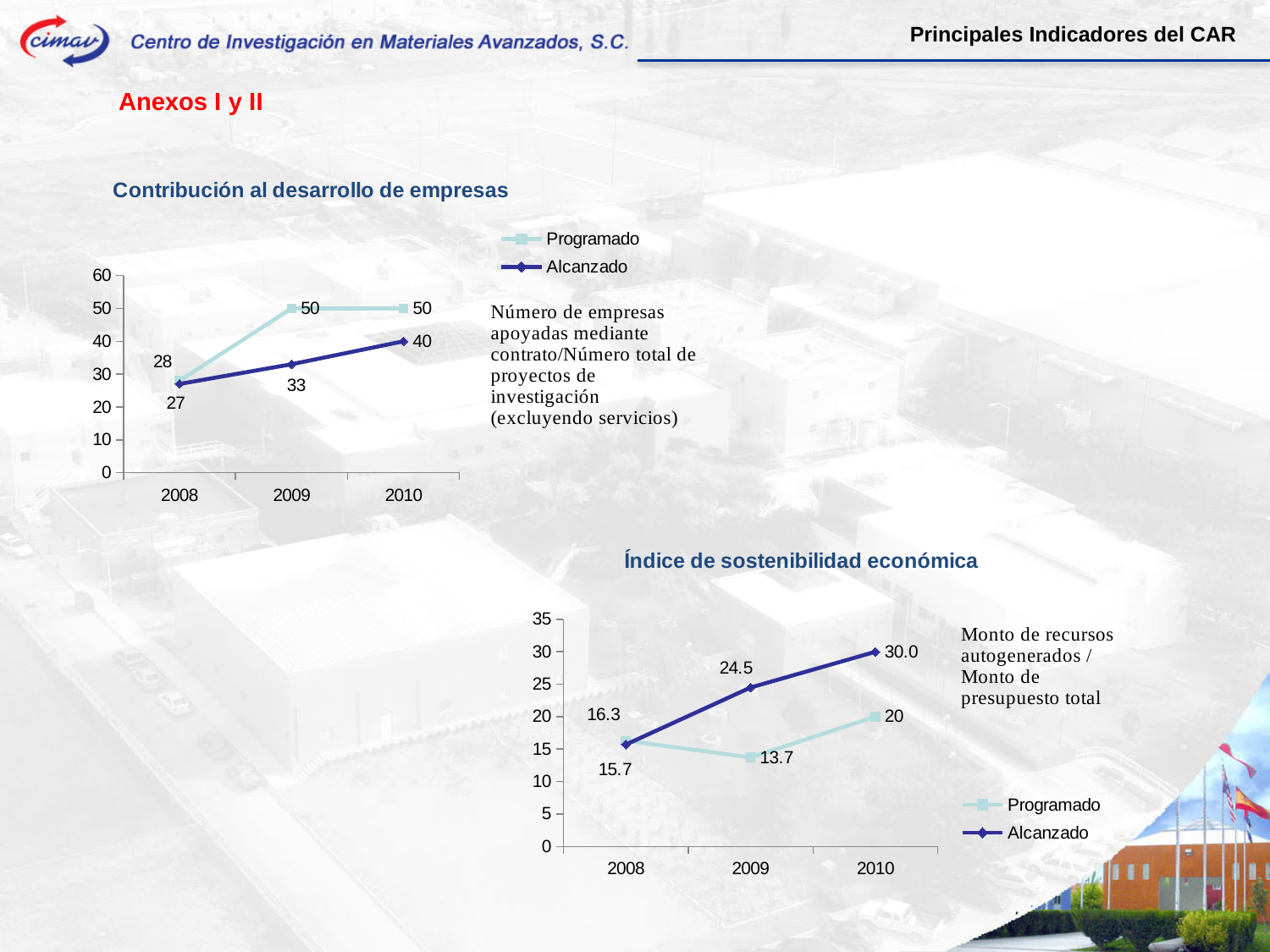
In the 'Contribución al desarrollo de empresas' chart, what is the difference between the Programado and Alcanzado values for 2010? 10 In the 'Índice de sostenibilidad económica' chart, which is larger in 2010, Programado or Alcanzado? Alcanzado In the 'Contribución al desarrollo de empresas' chart, what is the Alcanzado value for 2010? 40 In the 'Índice de sostenibilidad económica' chart, what is the Alcanzado value for 2009? 24.5 What kind of chart is 'Índice de sostenibilidad económica'? line chart In the 'Índice de sostenibilidad económica' chart, what is the Alcanzado value for 2010? 30.0 In the 'Contribución al desarrollo de empresas' chart, does the Alcanzado series rise or fall from 2008 to 2010? rise In the 'Índice de sostenibilidad económica' chart, which year has the highest Alcanzado value? 2010 In the 'Contribución al desarrollo de empresas' chart, what is the Programado value for 2009? 50 In the 'Contribución al desarrollo de empresas' chart, what is the Alcanzado value for 2009? 33 In the 'Índice de sostenibilidad económica' chart, what is the Programado value for 2009? 13.7 In the 'Contribución al desarrollo de empresas' chart, how many series does the legend list? 2